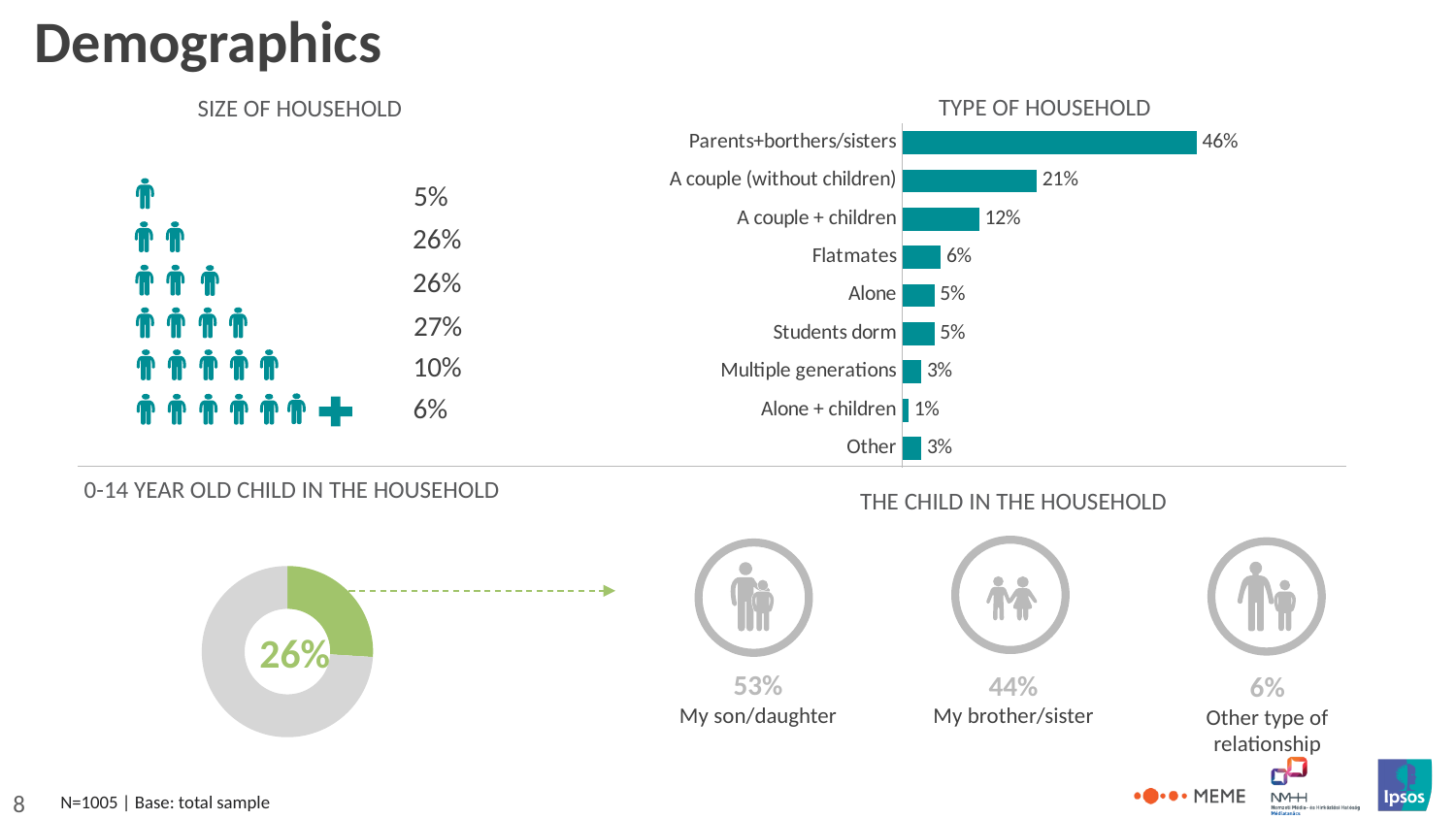
In the 'Type of household' chart, what is the value for 'Multiple generations'? 3% In the 'Type of household' chart, what is the difference between 'Parents+borthers/sisters' and 'A couple (without children)'? 25% In the 'Type of household' chart, what is the value for 'Flatmates'? 6% In the 'Size of household' chart, what is the value for the row with four person icons? 27% How many categories are shown in the 'Type of household' chart? 9 What kind of chart is the '0-14 year old child in the household' chart? Donut chart In the 'Type of household' chart, which category has the highest value? Parents+borthers/sisters In the '0-14 year old child in the household' donut chart, what share is shown for the highlighted slice? 26% In the 'Type of household' chart, which is larger: 'A couple + children' or 'Students dorm'? A couple + children In the 'Type of household' chart, what is the value for 'A couple (without children)'? 21% In the 'Type of household' chart, which category has the lowest value? Alone + children What kind of chart is the 'Type of household' chart? Bar chart